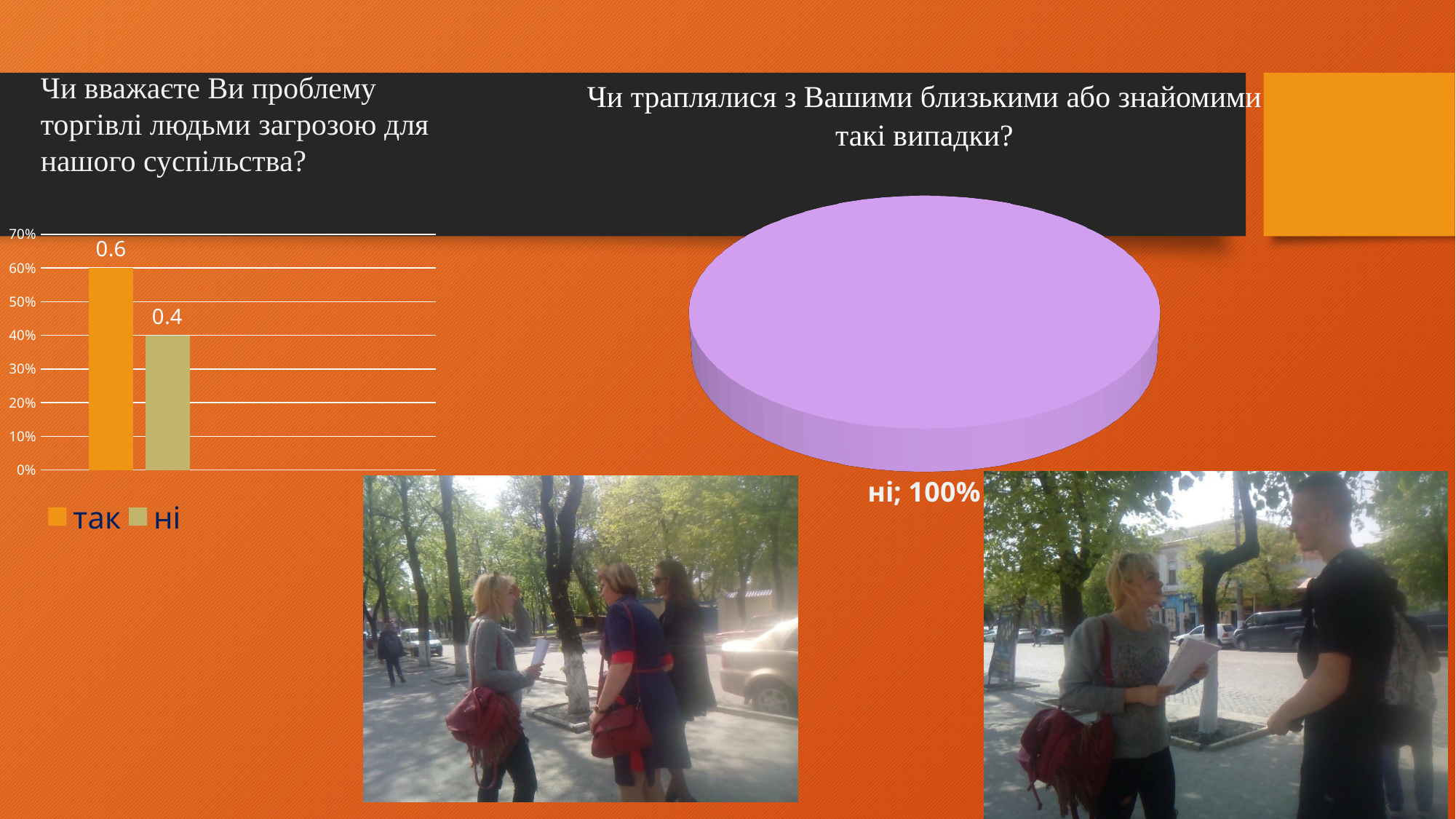
On the right pie chart, what share does the "ні" slice have? 100% What kind of chart is the one on the left of the slide? bar chart What is the title of the chart on the right of the slide? Чи траплялися з Вашими близькими або знайомими такі випадки? On the left bar chart, is the bar for "так" greater or less than 50%? greater On the left bar chart, which category has the lower value? ні On the right pie chart, how many slices are shown? 1 On the left bar chart, how many series does the legend list? 2 On the left bar chart, what is the value shown for "ні"? 0.4 On the left bar chart, what is the difference between the values for "так" and "ні"? 0.2 What kind of chart is the one on the right of the slide? pie chart On the left bar chart, what is the value shown for "так"? 0.6 On the left bar chart, which category has the higher value? так